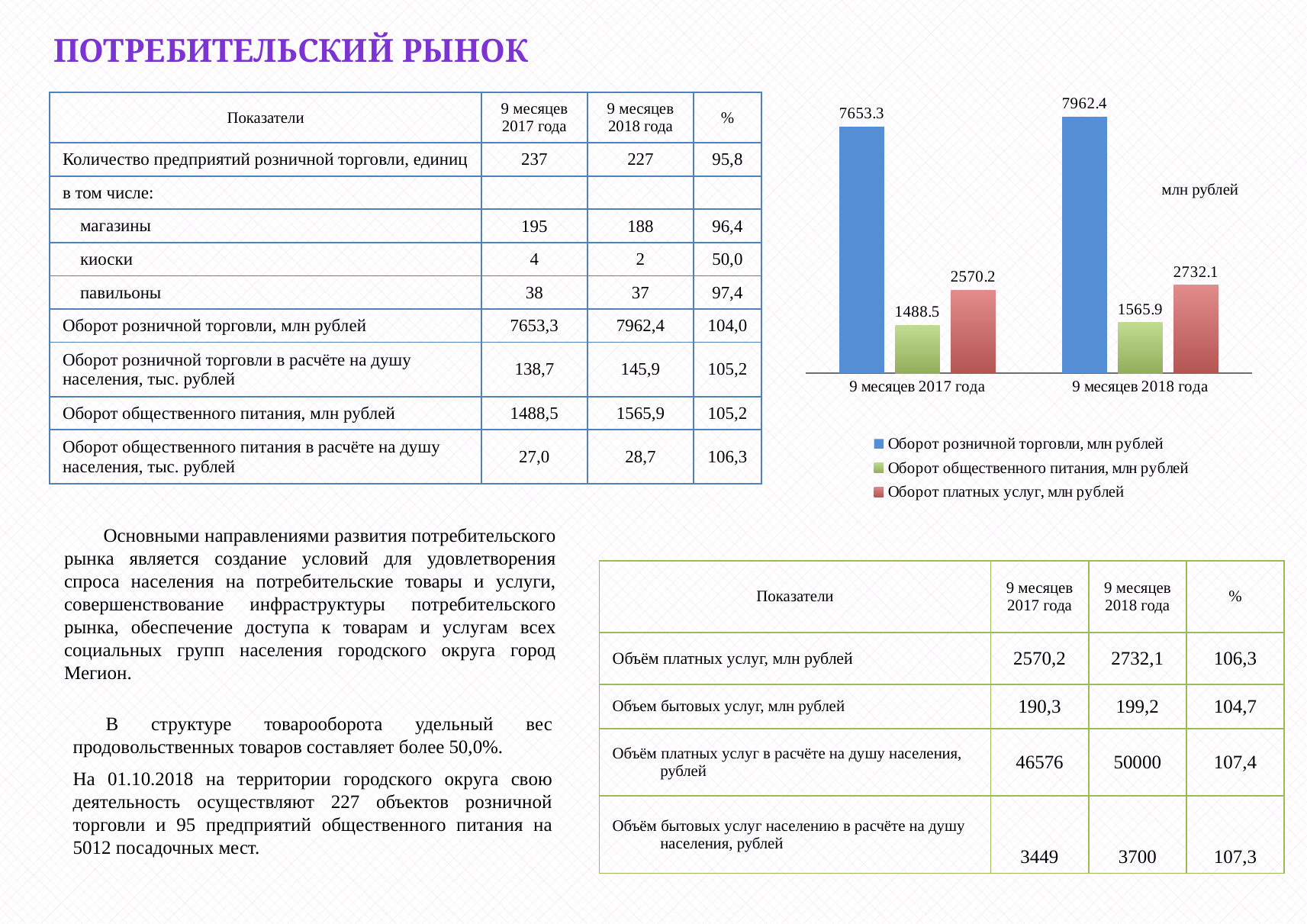
What type of chart is shown on the slide? bar chart By how much did Оборот розничной торговли, млн рублей increase from 9 месяцев 2017 года to 9 месяцев 2018 года in the chart? 309.1 Which series has the highest value for 9 месяцев 2017 года in the chart? Оборот розничной торговли, млн рублей How many series does the chart legend list? 3 What is the value of Оборот платных услуг, млн рублей for 9 месяцев 2018 года in the chart? 2732.1 What is the value of Оборот розничной торговли, млн рублей for 9 месяцев 2018 года in the chart? 7962.4 Which series has the lowest value for 9 месяцев 2018 года in the chart? Оборот общественного питания, млн рублей What is the difference between Оборот платных услуг, млн рублей for 9 месяцев 2018 года and 9 месяцев 2017 года in the chart? 161.9 How many categories are shown on the x axis of the chart? 2 Which is larger in the chart: Оборот платных услуг for 9 месяцев 2017 года or Оборот общественного питания for 9 месяцев 2018 года? Оборот платных услуг for 9 месяцев 2017 года What is the value of Оборот общественного питания, млн рублей for 9 месяцев 2017 года in the chart? 1488.5 Do the values of Оборот общественного питания, млн рублей rise or fall from 9 месяцев 2017 года to 9 месяцев 2018 года in the chart? rise